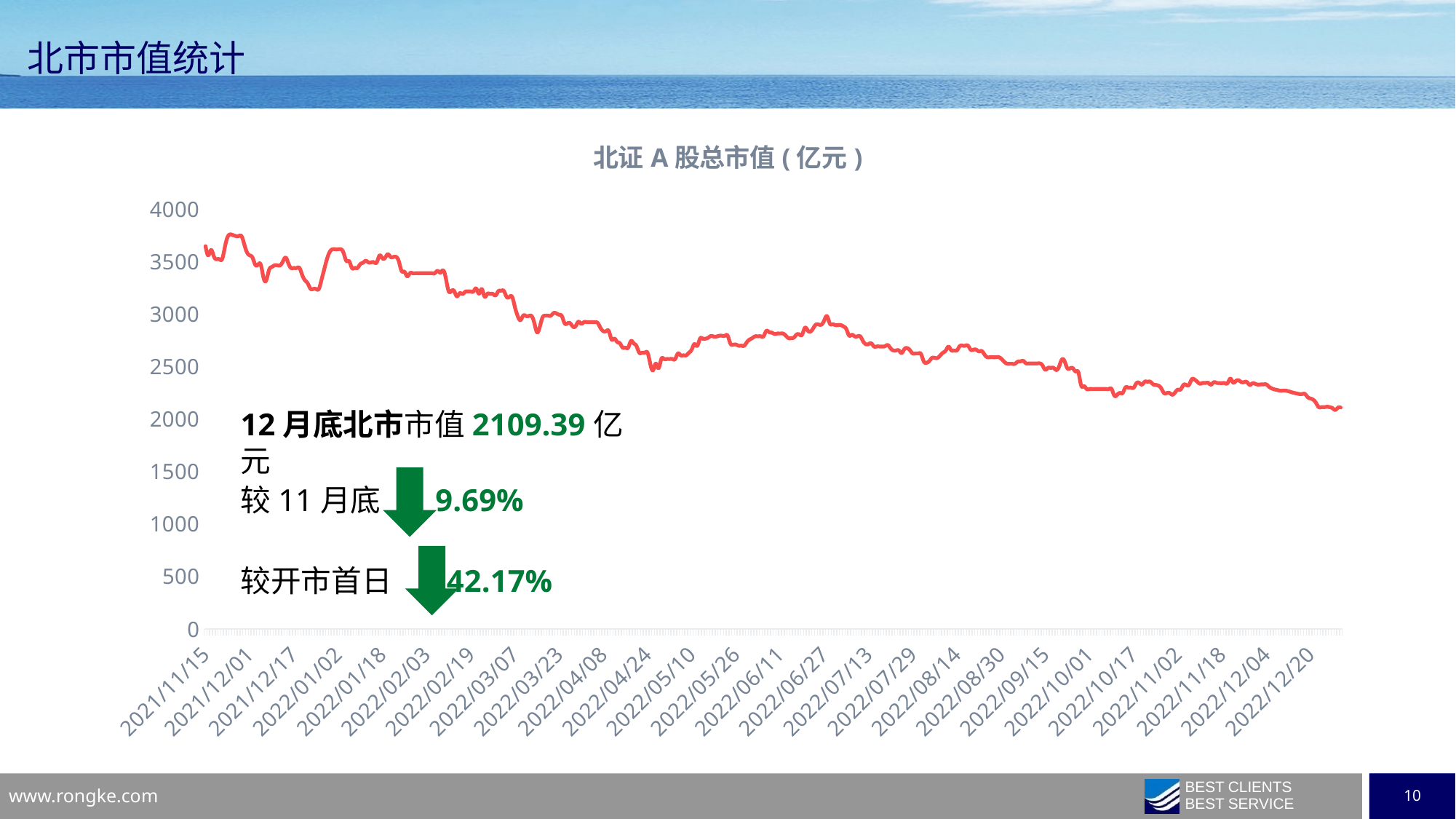
Overall, do the values rise or fall from left to right along the x axis? fall Is the value at 2022/12/20 greater or less than 2500? less What is the title of the chart? 北证A股总市值(亿元) Which is larger, the value at 2021/12/01 or the value at 2022/12/04? 2021/12/01 Is the value at 2022/04/24 greater or less than 3000? less What is the highest value shown on the y axis? 4000 What kind of chart is shown on the slide? line chart According to the annotation, by what percentage did the market value change compared with the end of November? down 9.69% Is the value at 2022/06/27 greater or less than 2500? greater According to the annotation, by what percentage did the market value change compared with the first trading day? down 42.17% According to the annotation on the chart, what was the 北市 market value at the end of December? 2109.39 亿元